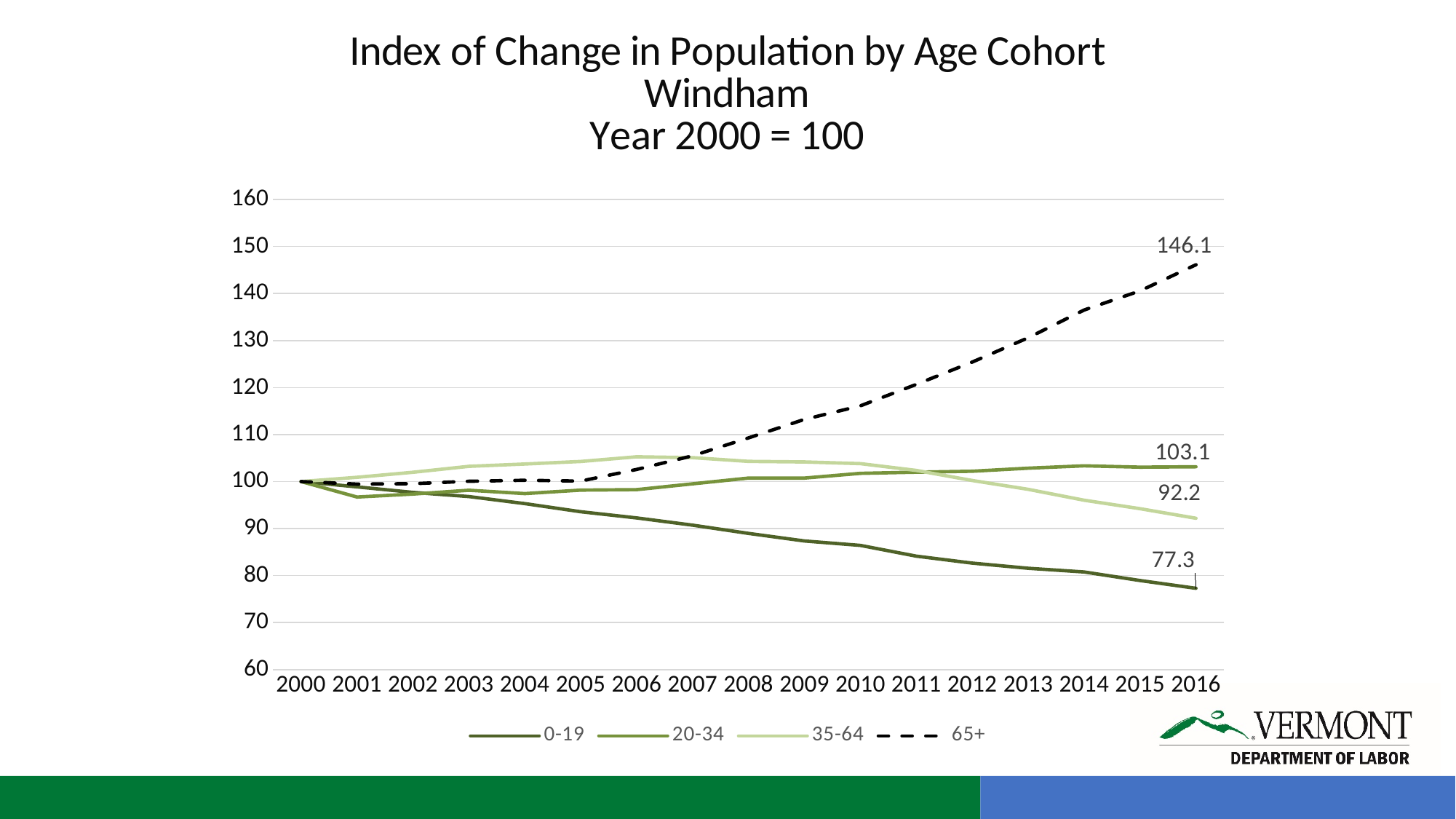
What is the 2016 index value for the 0-19 age cohort? 77.3 Does the 0-19 cohort index rise or fall from 2000 to 2016? Fall How many series does the legend list? 4 What is the difference between the 2016 index values of the 65+ and 0-19 cohorts? 68.8 What is the 2016 index value for the 20-34 age cohort? 103.1 Which age cohort has the highest index value in 2016? 65+ What is the 2016 index value for the 65+ age cohort? 146.1 What is the 2016 index value for the 35-64 age cohort? 92.2 Is the 65+ index value in 2010 greater or less than 120? less What kind of chart is shown on the slide? Line chart Which age cohort has the lowest index value in 2016? 0-19 In 2016, which cohort has the larger index value, 20-34 or 35-64? 20-34